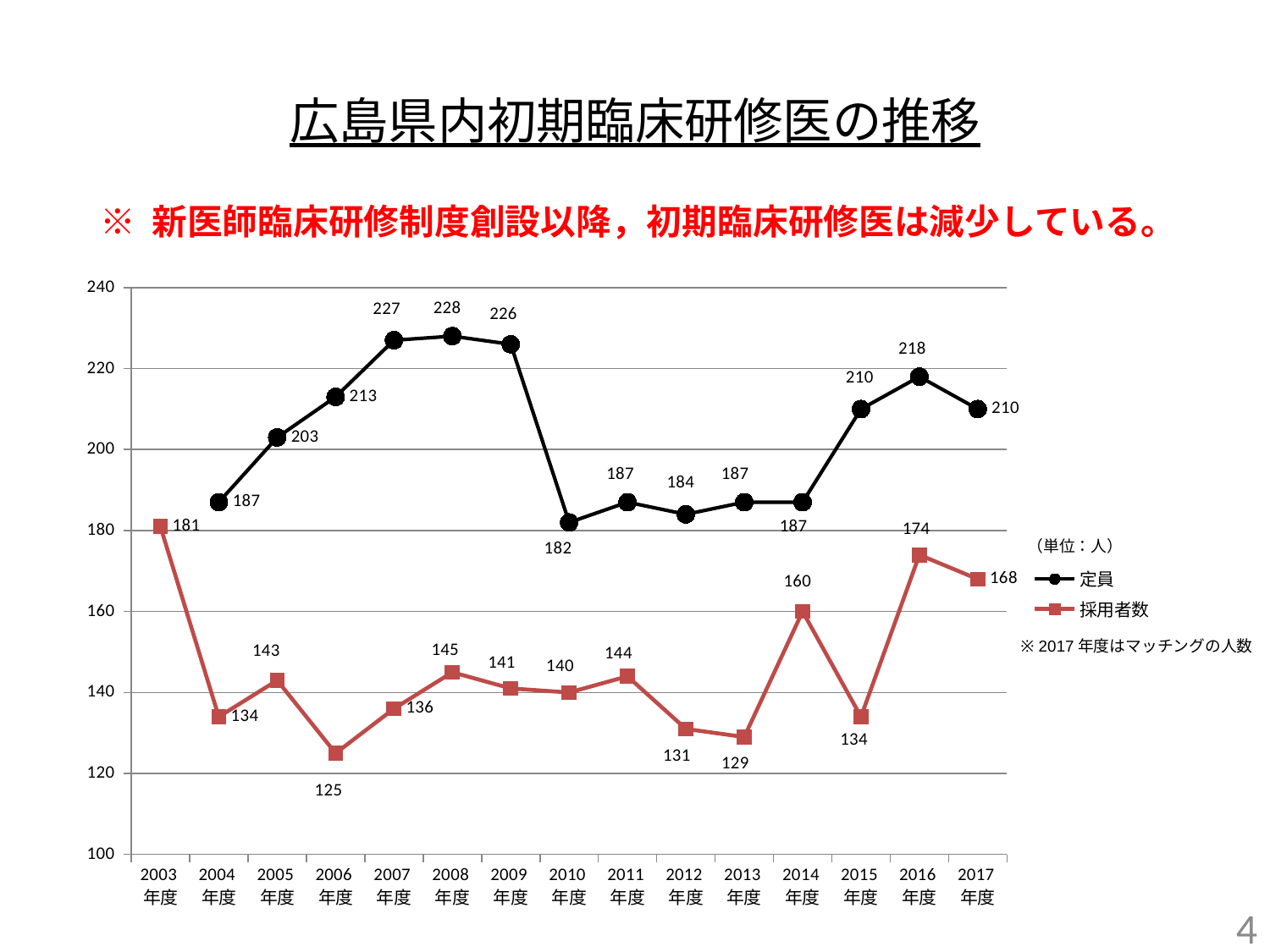
What is the value of 採用者数 for 2003年度? 181 How many years are shown on the x axis? 15 What is the value of 採用者数 for 2016年度? 174 What is the value of 定員 for 2008年度? 228 What type of chart is shown on the slide? line chart What is the title of the chart on the slide? 広島県内初期臨床研修医の推移 In which year is 採用者数 lowest? 2006年度 In which year is 定員 highest? 2008年度 What is the difference between 定員 and 採用者数 in 2017年度? 42 Which is larger, 採用者数 in 2014年度 or 採用者数 in 2015年度? 2014年度 How many series does the legend list? 2 Does 定員 rise or fall from 2004年度 to 2008年度? rise